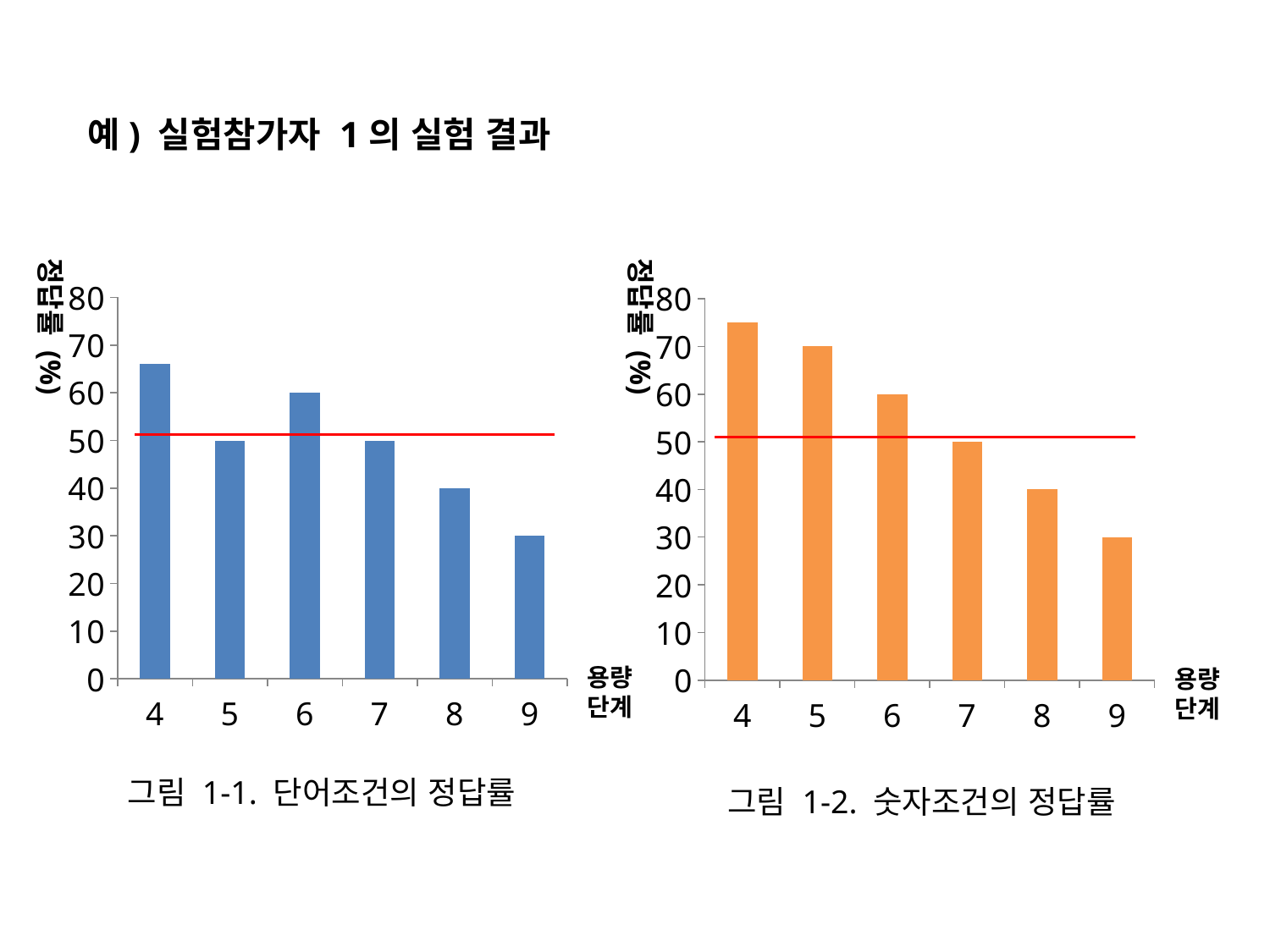
In the chart titled 그림 1-1. 단어조건의 정답률, which is larger, the value for 용량 단계 6 or 용량 단계 8? 용량 단계 6 In the chart titled 그림 1-2. 숫자조건의 정답률, what is the difference between the values for 용량 단계 5 and 용량 단계 9? 40 In the chart titled 그림 1-2. 숫자조건의 정답률, which 용량 단계 has the highest value? 4 In the chart titled 그림 1-1. 단어조건의 정답률, what is the value for 용량 단계 6? 60 What kind of chart is 그림 1-1. 단어조건의 정답률? bar chart In the chart titled 그림 1-2. 숫자조건의 정답률, what is the value for 용량 단계 8? 40 In the chart titled 그림 1-2. 숫자조건의 정답률, is the value for 용량 단계 4 greater or less than 70? greater How many 용량 단계 categories are shown in the chart titled 그림 1-2. 숫자조건의 정답률? 6 In the chart titled 그림 1-1. 단어조건의 정답률, is the value for 용량 단계 4 greater or less than 60? greater In the chart titled 그림 1-1. 단어조건의 정답률, what is the value for 용량 단계 9? 30 In the chart titled 그림 1-2. 숫자조건의 정답률, what is the value for 용량 단계 5? 70 In the chart titled 그림 1-1. 단어조건의 정답률, which 용량 단계 has the lowest value? 9